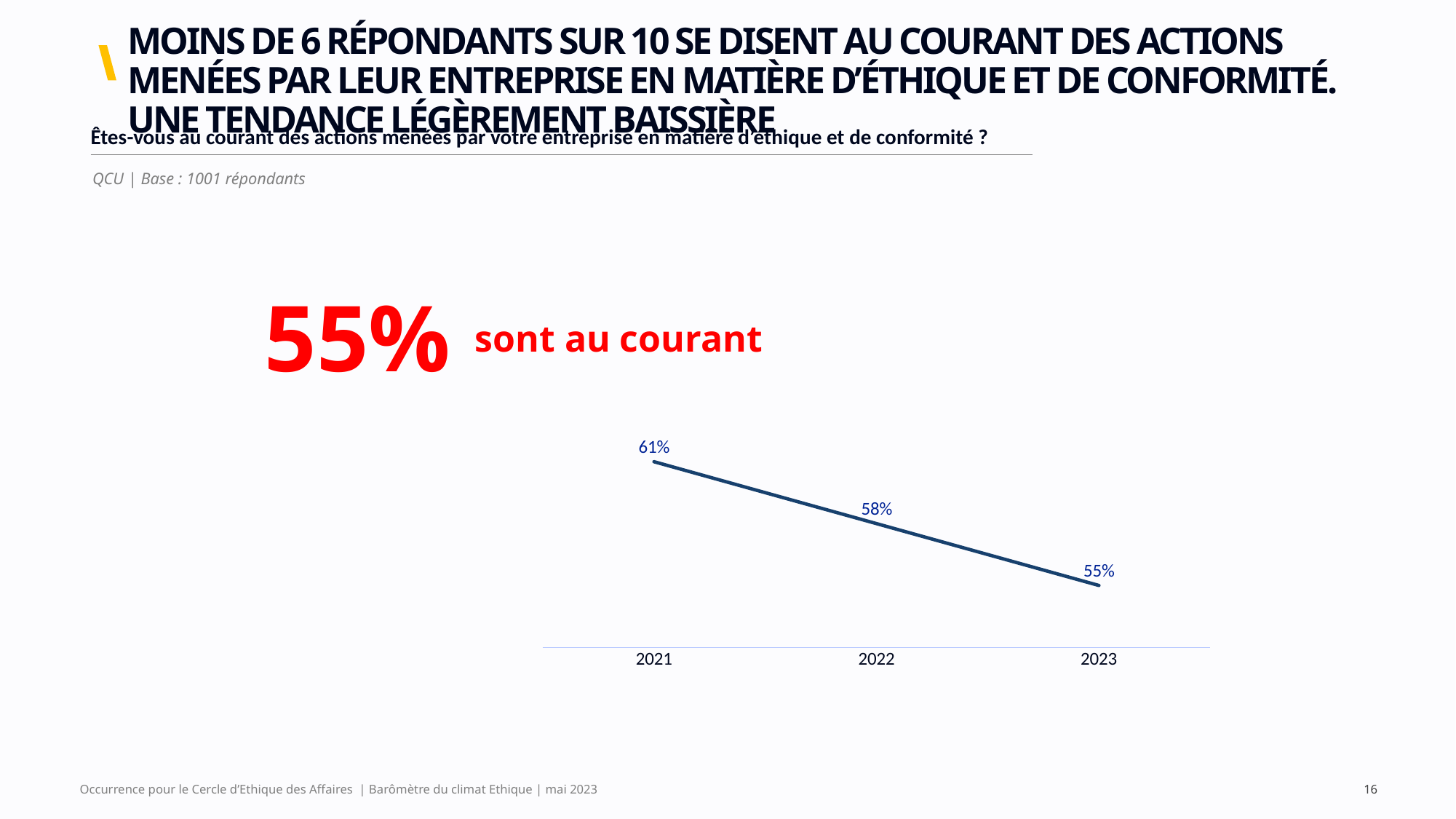
Which is larger, the value for 2022 or the value for 2023? 2022 What large percentage is highlighted in red on the slide? 55% Which year has the highest value? 2021 What is the difference between the 2021 and 2022 values? 3% What is the value for 2022? 58% What is the difference between the 2021 and 2023 values? 6% Do the values rise or fall from 2021 to 2023? fall Which year has the lowest value? 2023 What kind of chart is shown on the slide? line chart What is the value for 2021? 61% What is the value for 2023? 55% How many data points are plotted on the chart? 3